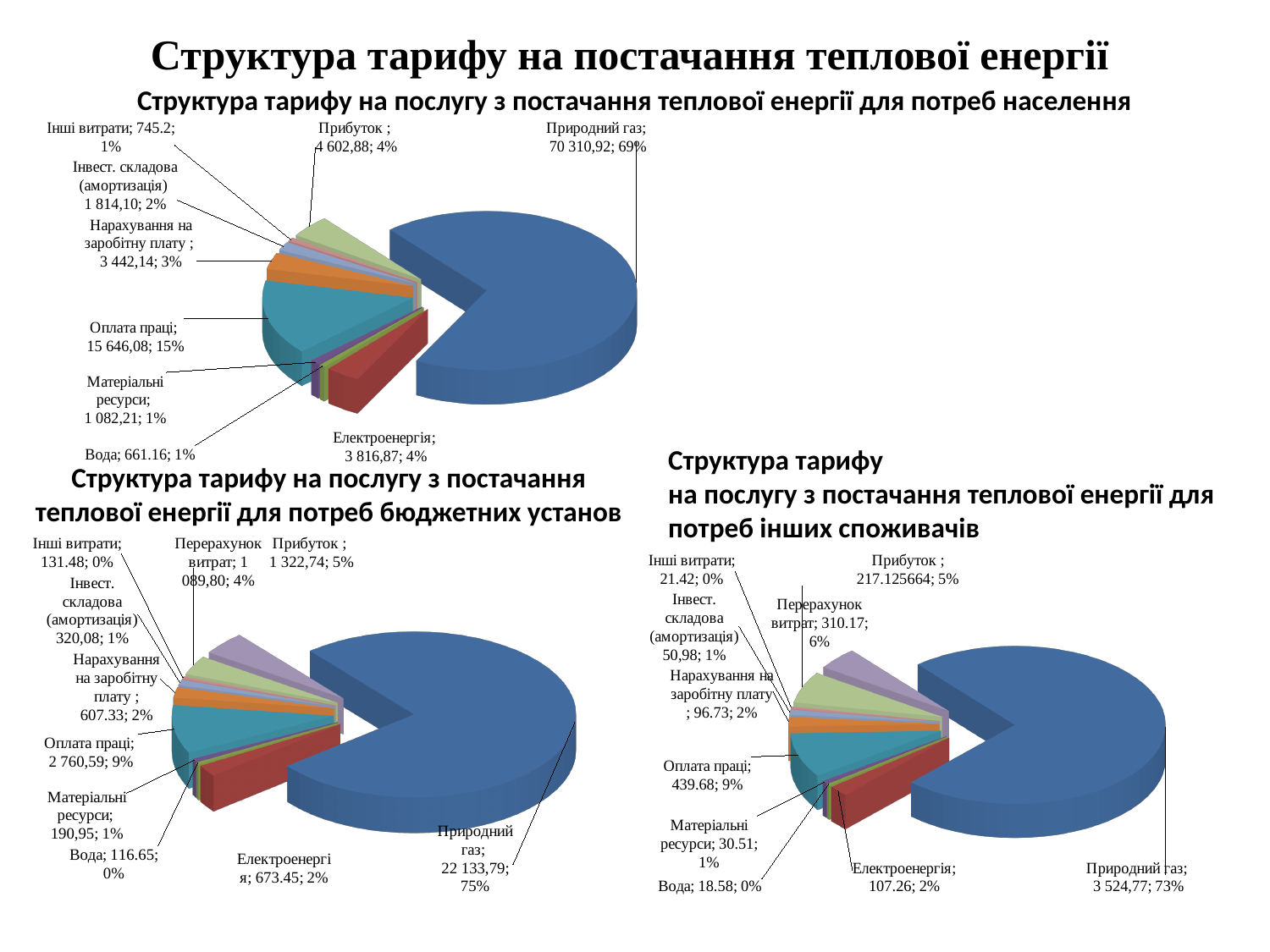
In the chart for потреб бюджетних установ, what value is shown for Оплата праці? 2 760,59 In the chart for потреб інших споживачів, what share of the pie does Природний газ take? 73% What type of chart is used on this slide? Pie chart In the chart 'Структура тарифу на послугу з постачання теплової енергії для потреб населення', what value is shown for Природний газ? 70 310,92 In the chart for потреб населення, which category has the largest slice? Природний газ In the chart for потреб бюджетних установ, how many categories are shown? 10 In the chart for потреб бюджетних установ, what share of the pie does Природний газ take? 75% In the chart for потреб населення, what share of the pie does Оплата праці take? 15% In the chart for потреб населення, how many categories are shown? 9 In the chart for потреб бюджетних установ, which is larger: Перерахунок витрат or Прибуток? Прибуток In the chart for потреб інших споживачів, what value is shown for Перерахунок витрат? 310.17 In the chart for потреб населення, which is larger: Прибуток or Електроенергія? Прибуток